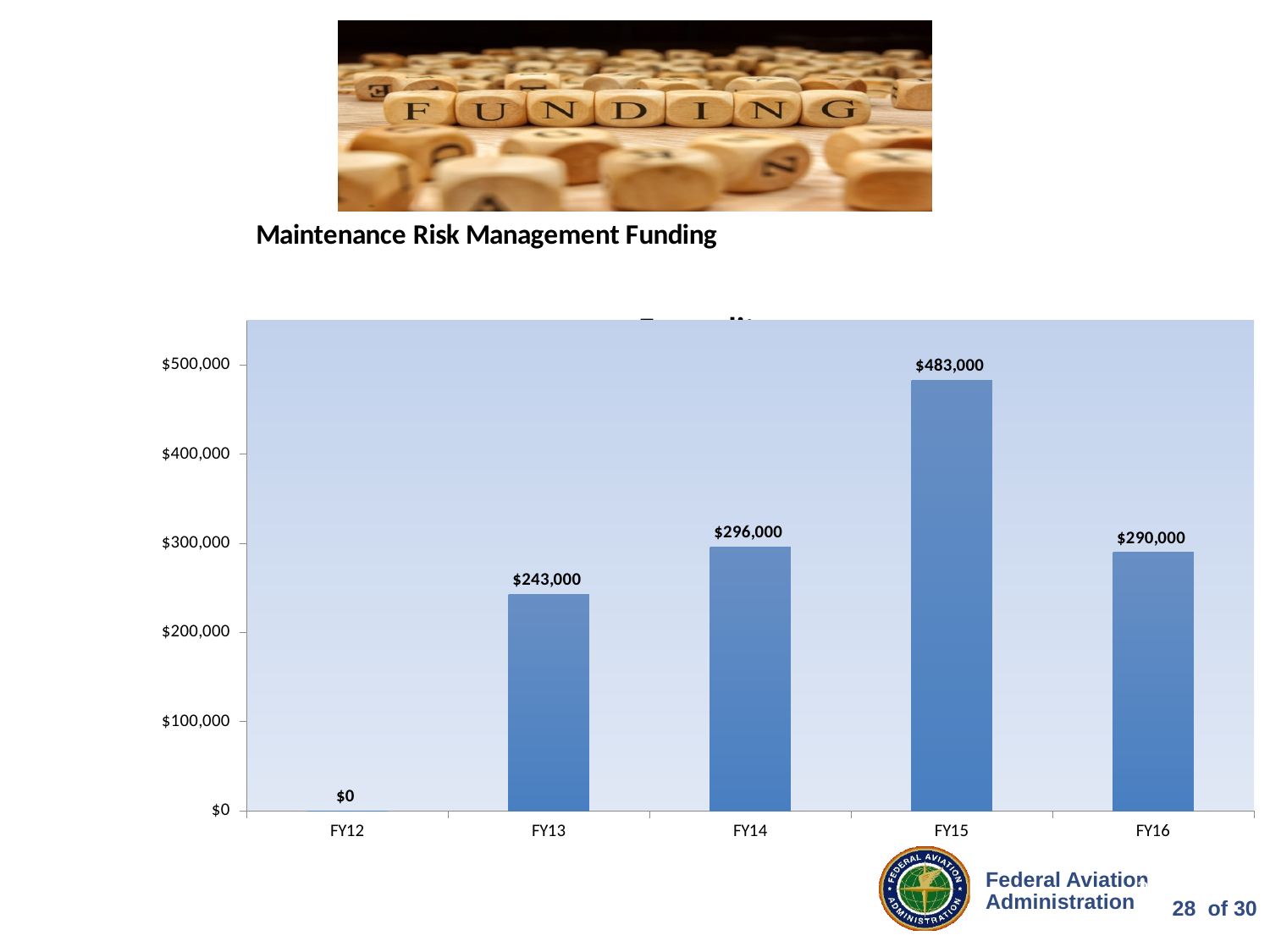
Is the value for FY14 greater or less than $200,000? greater Which fiscal year has the lowest value? FY12 Which fiscal year has the highest value? FY15 How many fiscal years are shown on the x axis? 5 What is the value for FY12? $0 What is the difference between the values for FY14 and FY16? $6,000 What kind of chart is shown on the slide? bar chart What is the value for FY13? $243,000 Which is larger, the value for FY13 or the value for FY16? FY16 What is the difference between the values for FY15 and FY14? $187,000 What is the value for FY16? $290,000 What is the value for FY15? $483,000